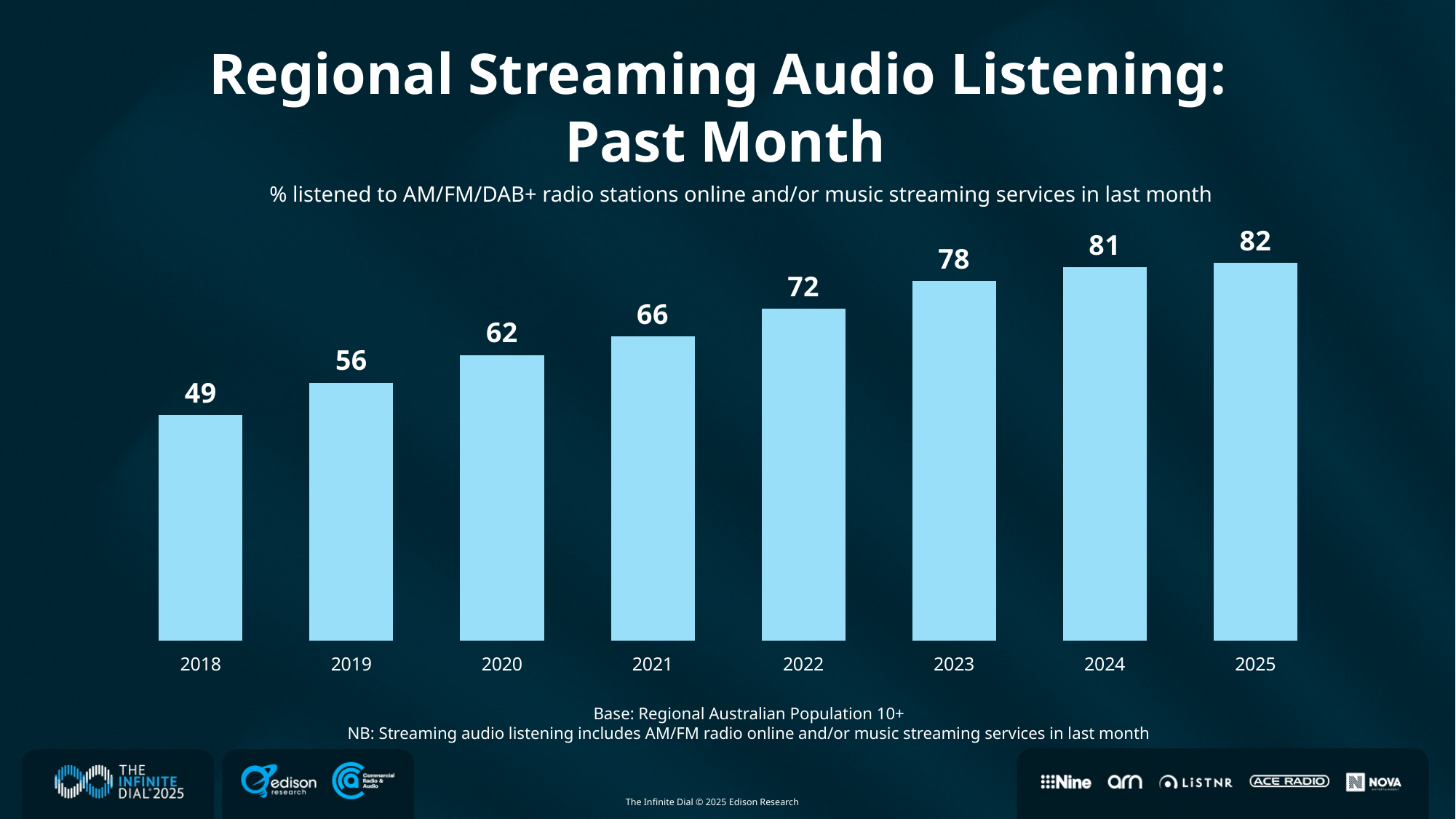
What is the difference between the values for 2025 and 2018? 33 Which year has the lowest value? 2018 How many years are shown on the x axis? 8 What is the difference between the values for 2021 and 2020? 4 What is the value for 2022? 72 Do the values rise or fall from 2018 to 2025? Rise What is the title of the chart? Regional Streaming Audio Listening: Past Month What kind of chart is this? Bar chart What is the value for 2025? 82 Which year has the highest value? 2025 Which is larger, the value for 2019 or the value for 2023? 2023 What is the value for 2018? 49